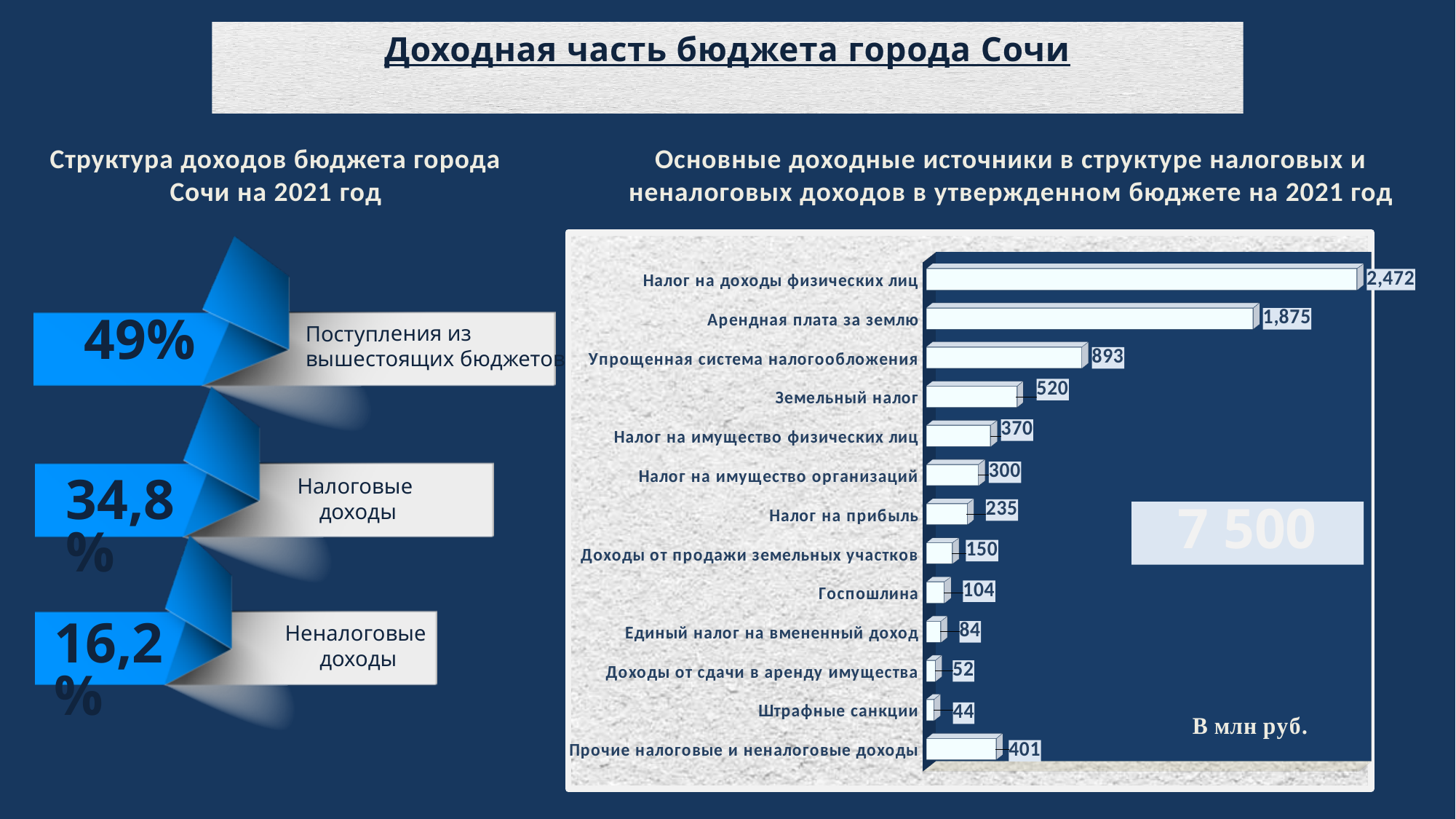
In the bar chart on the right, what is the difference between Налог на доходы физических лиц and Арендная плата за землю? 597 In the bar chart on the right, what is the value for Арендная плата за землю? 1,875 In the bar chart on the right, which category has the highest value? Налог на доходы физических лиц What type of chart is shown on the right side of the slide? Bar chart In the bar chart on the right, what is the value for Налог на доходы физических лиц? 2,472 In what units are the values in the bar chart on the right expressed? В млн руб. In the bar chart on the right, which category has the lowest value? Штрафные санкции How many categories are shown in the bar chart on the right? 13 In the bar chart on the right, what is the value for Земельный налог? 520 In the bar chart on the right, what is the value for Штрафные санкции? 44 In the bar chart on the right, what is the difference between Упрощенная система налогообложения and Земельный налог? 373 In the bar chart on the right, which is larger: Прочие налоговые и неналоговые доходы or Налог на имущество физических лиц? Прочие налоговые и неналоговые доходы